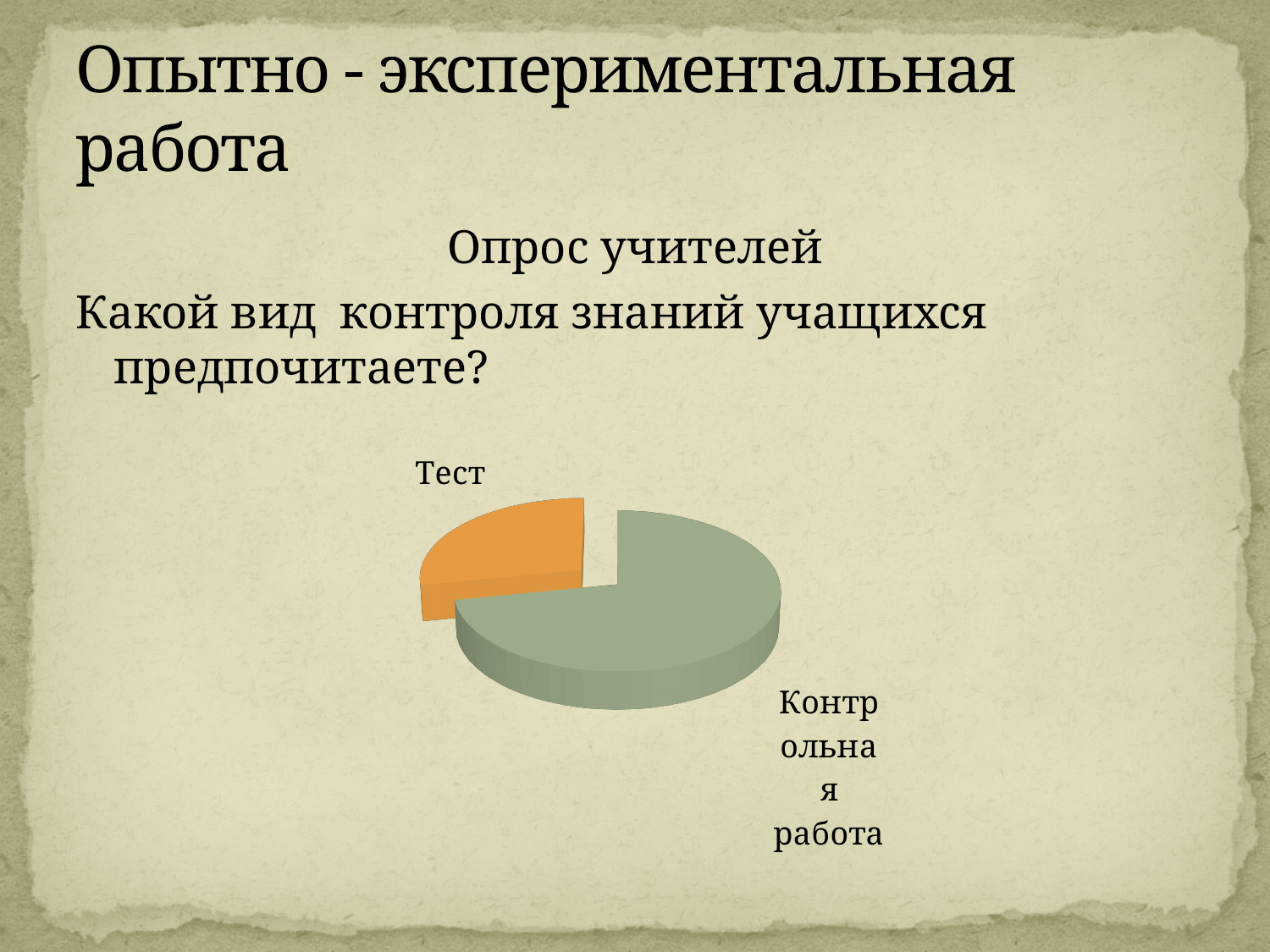
What kind of chart is shown on the slide? pie chart Which category has the largest slice in the pie chart? Контрольная работа Which slice is larger, Тест or Контрольная работа? Контрольная работа What colour is the slice for Контрольная работа? green How many slices does the pie chart have? 2 Which category has the smallest slice in the pie chart? Тест What colour is the slice for Тест? orange